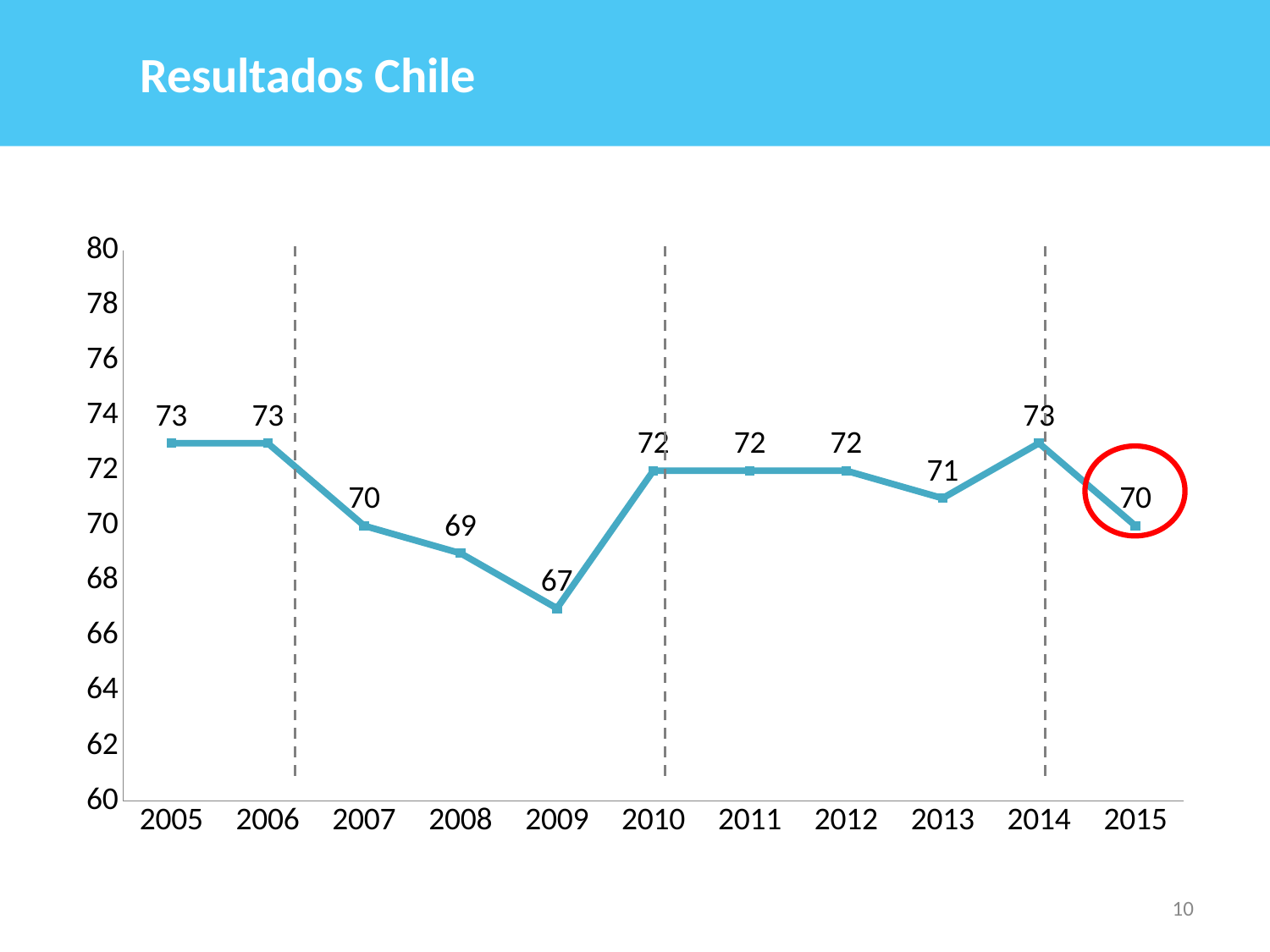
Is the value for 2008 greater or less than 70? less What is the value for 2015? 70 What is the title of the slide? Resultados Chile What kind of chart is shown on the slide? line chart Which is larger, the value for 2010 or the value for 2013? 2010 How many years are plotted on the x axis? 11 Do the values rise or fall from 2006 to 2009? fall What is the difference between the values for 2005 and 2009? 6 What is the value for 2013? 71 Which year has the lowest value? 2009 What is the value for 2009? 67 What is the difference between the values for 2014 and 2015? 3